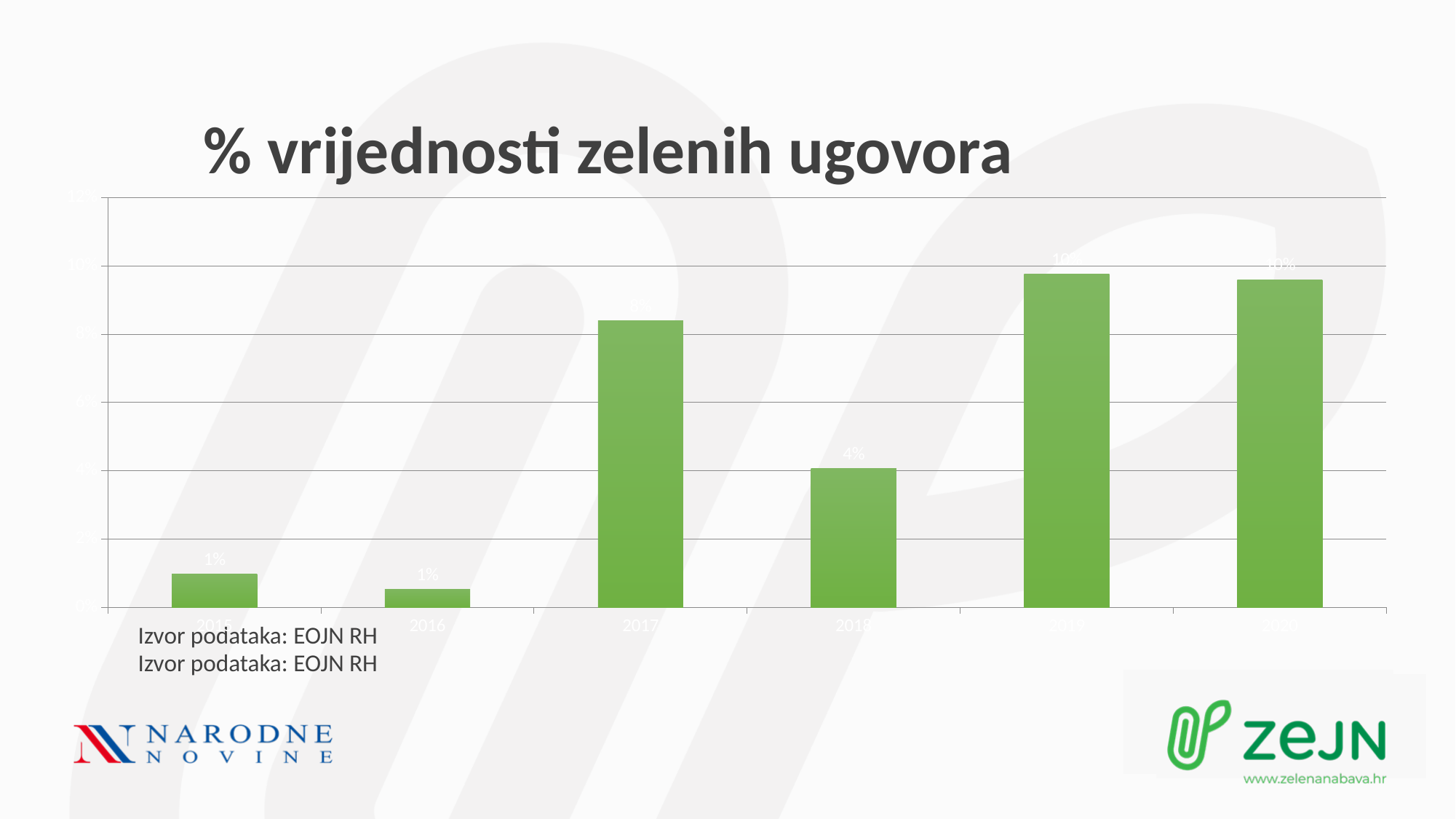
What is the title of the chart? % vrijednosti zelenih ugovora Which is larger, the value for 2016 or the value for 2020? 2020 What is the value for 2015? 1% What is the difference between the values for 2019 and 2018? 6% Which is larger, the value for 2017 or the value for 2018? 2017 What is the value for 2019? 10% What kind of chart is shown on the slide? bar chart What is the difference between the values for 2017 and 2018? 4% How many years are shown on the x axis? 6 What is the value for 2017? 8% What is the value for 2018? 4% Is the value for 2017 greater or less than 6%? greater